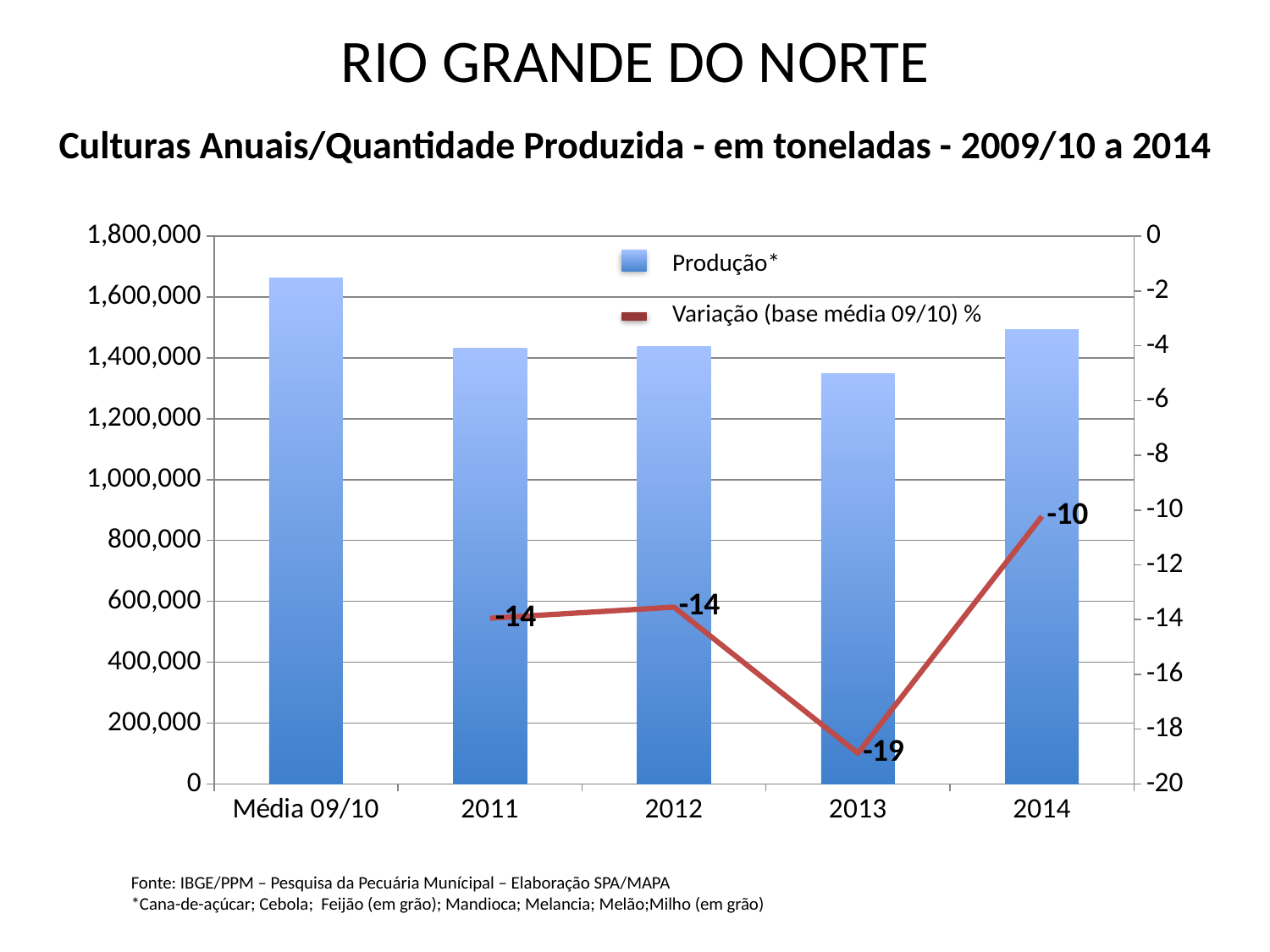
Which category has the highest Produção* bar? Média 09/10 How many series does the legend list? 2 Which year has the lowest Produção* bar? 2013 What is the value of Variação (base média 09/10) % for 2013? -19 What is the value of Variação (base média 09/10) % for 2011? -14 What is the difference between the Variação values for 2014 and 2013? 9 How many categories are shown on the x axis? 5 Is the Produção* value for Média 09/10 greater or less than 1,600,000? greater Is the Produção* value for 2013 greater or less than 1,400,000? less Which year has the lowest Variação (base média 09/10) % value? 2013 What is the value of Variação (base média 09/10) % for 2014? -10 Which has a larger Produção* value, 2013 or 2014? 2014